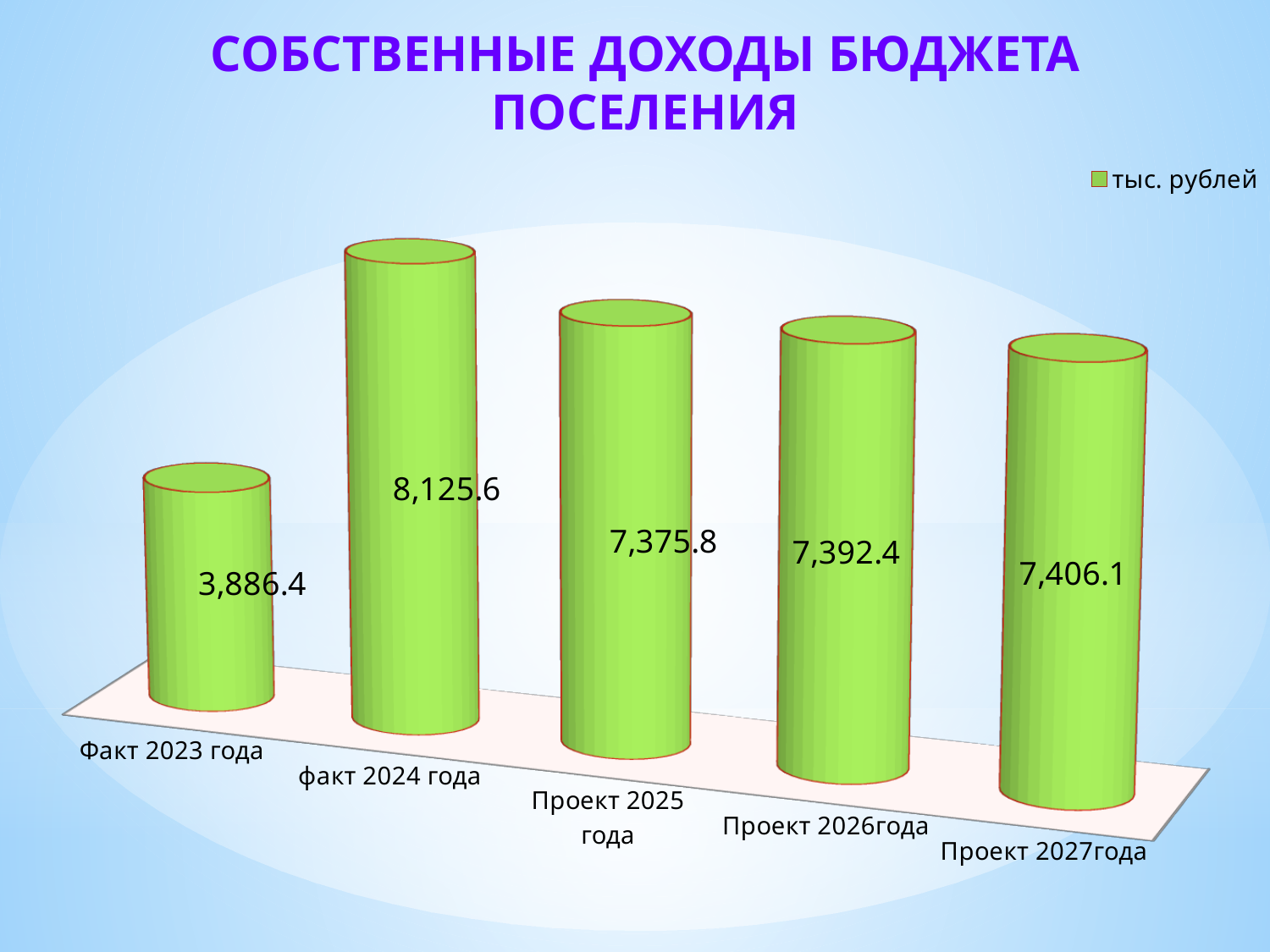
What is the value for Факт 2023 года? 3,886.4 What is the value for факт 2024 года? 8,125.6 What kind of chart is shown on the slide? bar chart How many categories are shown in the chart? 5 Which category has the highest value? факт 2024 года What is the value for Проект 2025 года? 7,375.8 What is the value for Проект 2027года? 7,406.1 What is the difference between the values for Проект 2027года and Проект 2025 года? 30.3 What is the legend entry shown for the series? тыс. рублей What is the difference between the values for факт 2024 года and Факт 2023 года? 4,239.2 Which is larger, the value for факт 2024 года or the value for Проект 2025 года? факт 2024 года Which category has the lowest value? Факт 2023 года